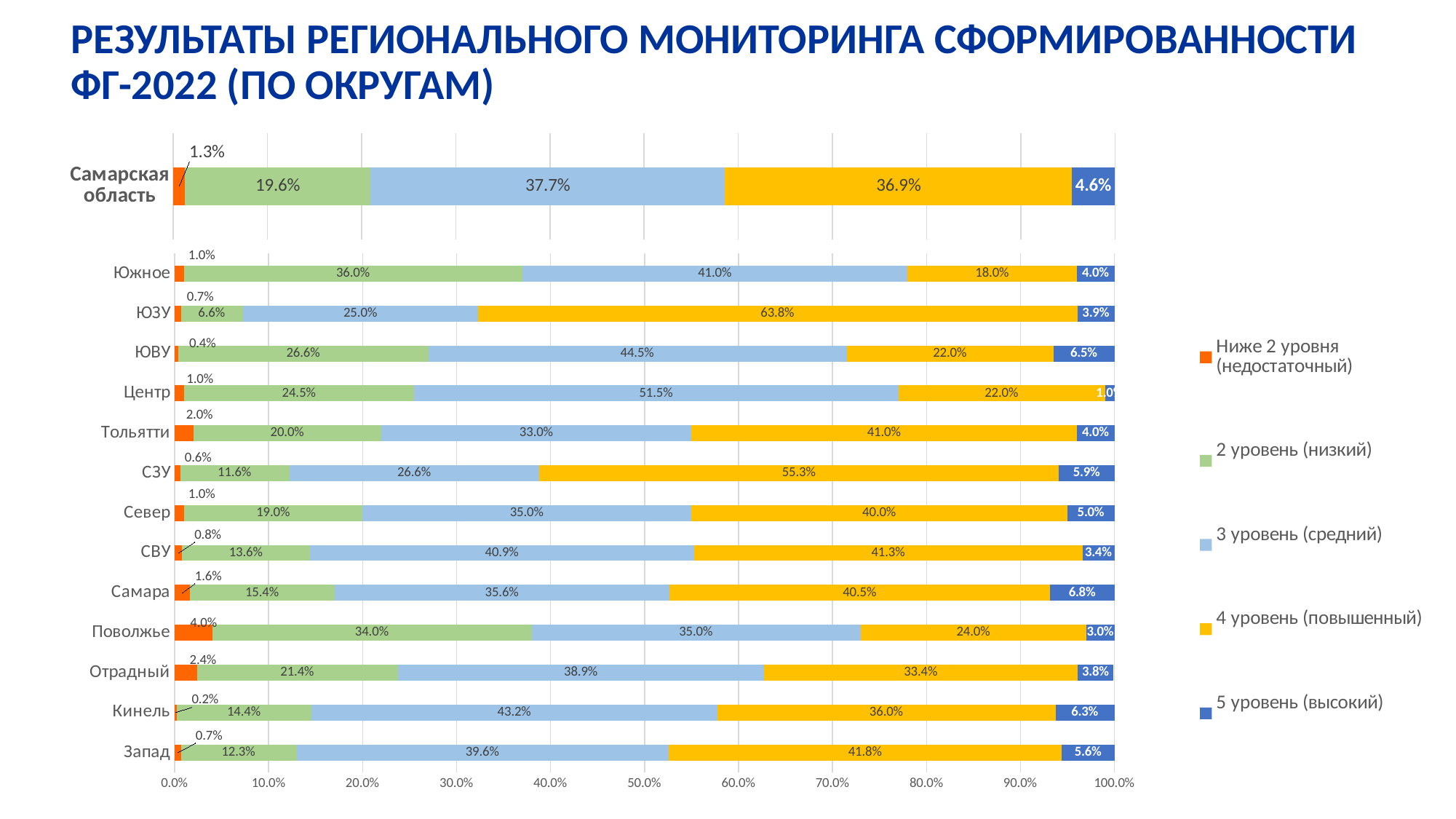
What is the difference between the '2 уровень (низкий)' values for Южное and ЮЗУ? 29.4% Which colour represents '5 уровень (высокий)' in the legend? Dark blue What is the value of '4 уровень (повышенный)' for ЮЗУ? 63.8% Which district has the highest value for '4 уровень (повышенный)'? ЮЗУ How many categories (regions/districts) are plotted on the chart? 14 What is the value of '3 уровень (средний)' for Самарская область? 37.7% Which district has the lowest value for 'Ниже 2 уровня (недостаточный)'? Кинель What is the total of the stacked bar for Южное? 100.0% Which is larger: the '3 уровень (средний)' value for Центр or for Тольятти? Центр What kind of chart is shown on the slide? Stacked bar chart How many series does the legend list? 5 What is the value of '5 уровень (высокий)' for Самара? 6.8%